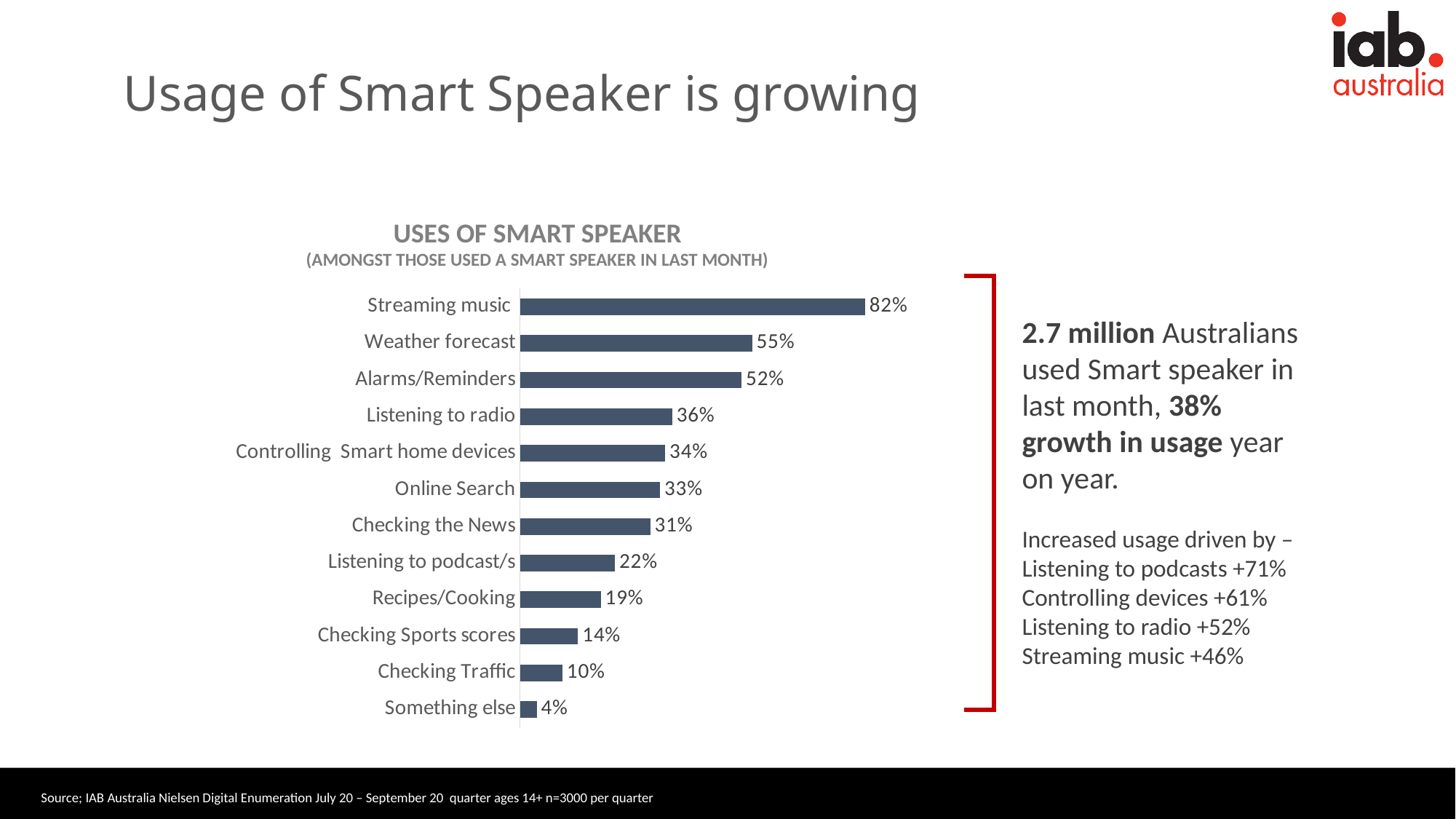
What is the title of the chart? USES OF SMART SPEAKER What percentage of smart speaker users use it for streaming music? 82% How many categories are shown in the chart? 12 Which use of smart speaker has the highest percentage? Streaming music What is the value for Controlling Smart home devices? 34% Which is larger, Listening to podcast/s or Recipes/Cooking? Listening to podcast/s What type of chart is shown on the slide? Bar chart What is the value for Checking Traffic? 10% Which is larger, Checking the News or Online Search? Online Search What is the difference between Weather forecast and Alarms/Reminders? 3% What is the difference between Streaming music and Listening to radio? 46% Which category has the lowest percentage? Something else